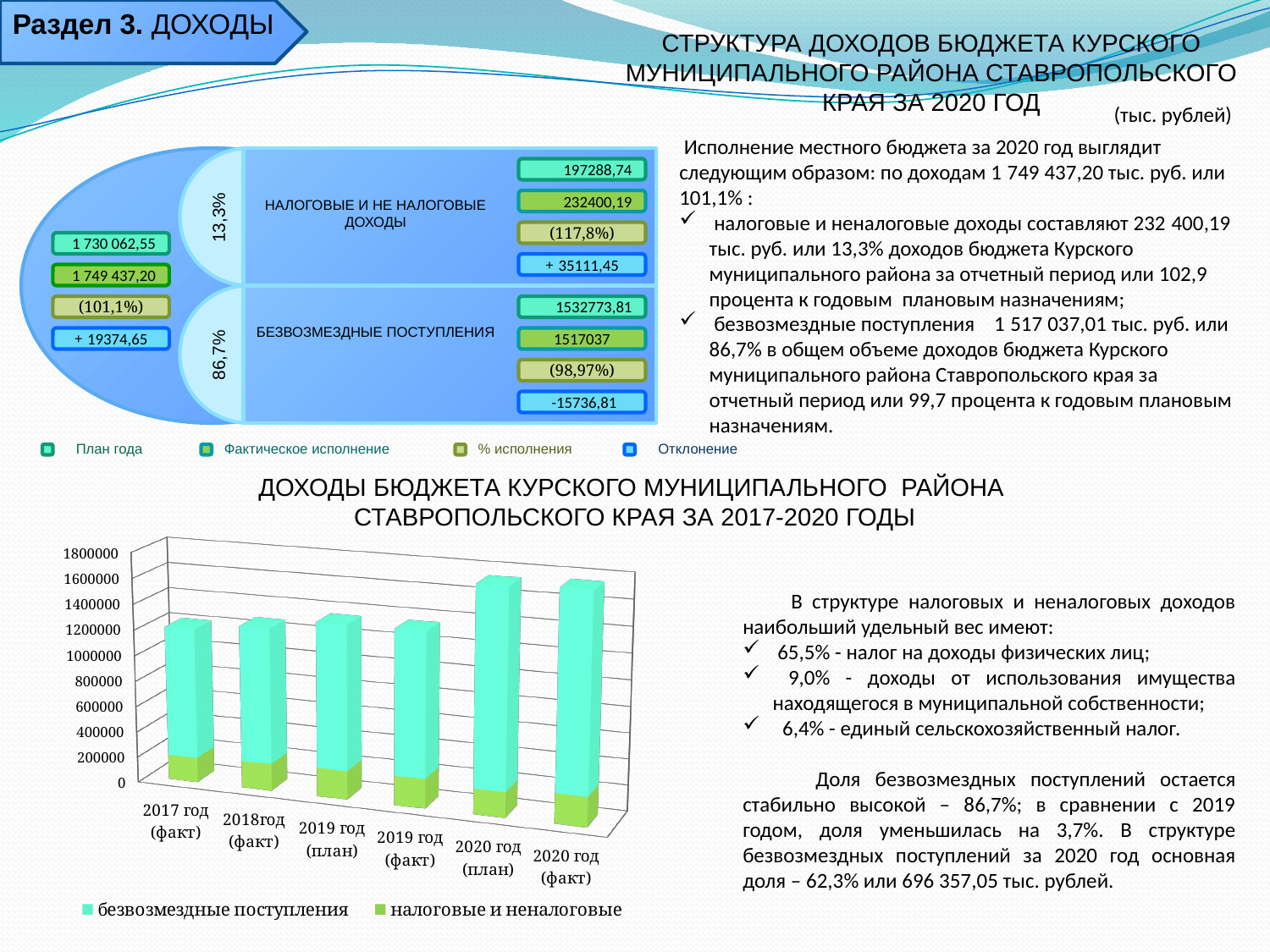
What is the title of the bar chart? ДОХОДЫ БЮДЖЕТА КУРСКОГО МУНИЦИПАЛЬНОГО РАЙОНА СТАВРОПОЛЬСКОГО КРАЯ ЗА 2017-2020 ГОДЫ What are the two series named in the legend of the bar chart? безвозмездные поступления; налоговые и неналоговые Is the total bar height for 2020 год (план) greater or less than 1400000? greater Which has the larger total bar: 2020 год (план) or 2017 год (факт)? 2020 год (план) Is the value of налоговые и неналоговые for 2020 год (факт) greater or less than 400000? less How many series does the legend of the bar chart list? 2 Is the total bar height for 2017 год (факт) greater or less than 1000000? greater What kind of chart is shown at the bottom of the slide? Stacked bar chart How many categories (years) are shown on the x axis of the bar chart? 6